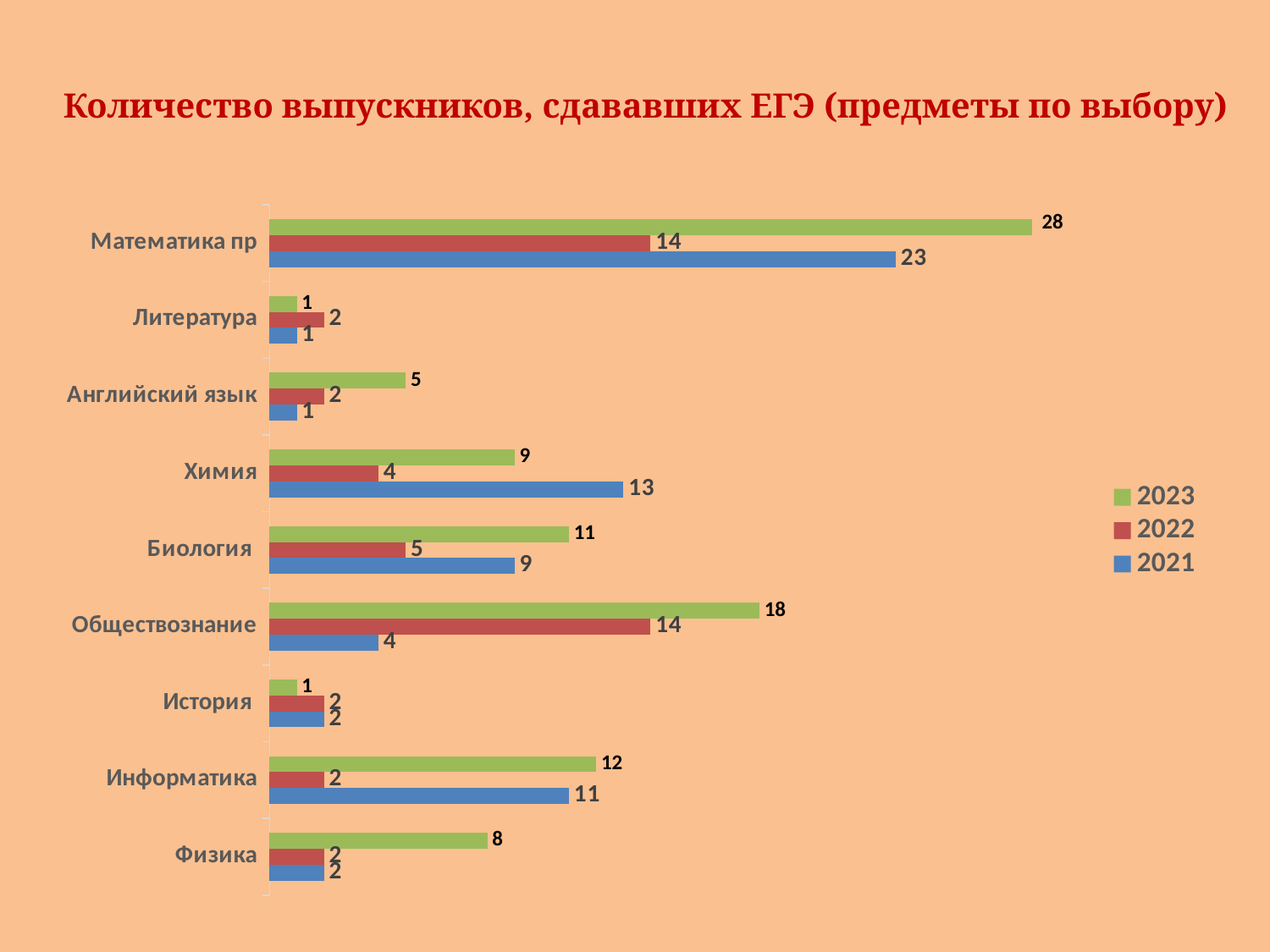
What is the difference between the 2023 and 2022 values for Математика пр? 14 What is the value for Химия in the 2021 series? 13 Which is larger for Биология: the 2023 value or the 2021 value? 2023 What is the value for Обществознание in the 2022 series? 14 What is the difference between the 2023 and 2021 values for Информатика? 1 What is the value for Математика пр in the 2023 series? 28 Which category has the lowest value in the 2022 series? Литература, Английский язык, История, Информатика, Физика (all 2) What kind of chart is shown on the slide? Bar chart How many categories are shown on the chart? 9 Which category has the highest value in the 2023 series? Математика пр What is the title of the chart? Количество выпускников, сдававших ЕГЭ (предметы по выбору) How many series does the legend list? 3